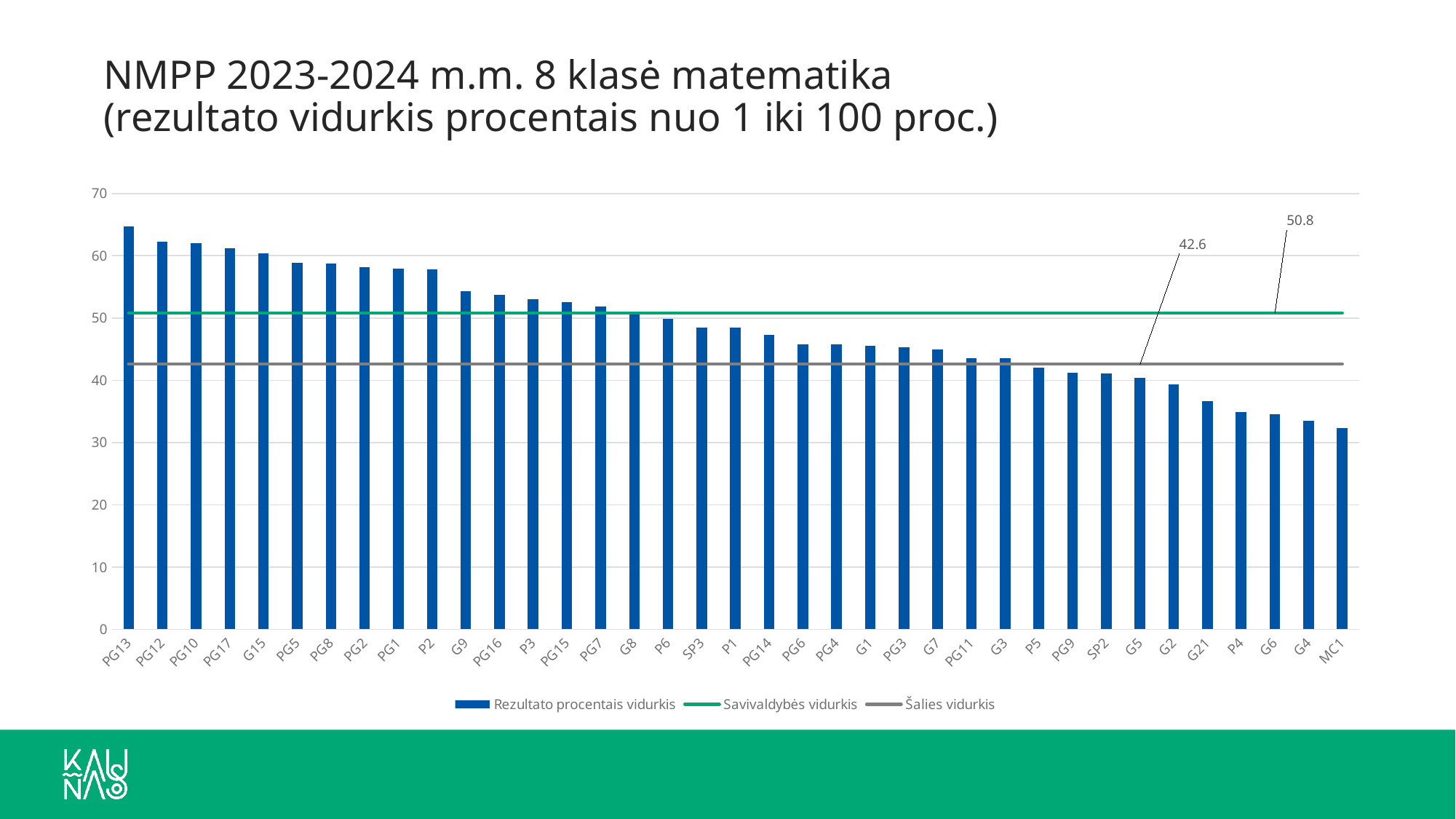
Which school has the lowest result average? MC1 Which line is drawn in green: Savivaldybės vidurkis or Šalies vidurkis? Savivaldybės vidurkis Do the bar values rise or fall from left to right along the x axis? fall What is the difference between the Savivaldybės vidurkis and the Šalies vidurkis? 8.2 How many series does the legend list? 3 Is the value for G21 greater or less than 40? less What type of chart is shown on the slide? bar chart Is the value for PG13 greater or less than 60? greater What is the value of the Šalies vidurkis line? 42.6 Which school has the highest result average? PG13 How many schools (bars) are plotted in the chart? 37 What is the value of the Savivaldybės vidurkis line? 50.8